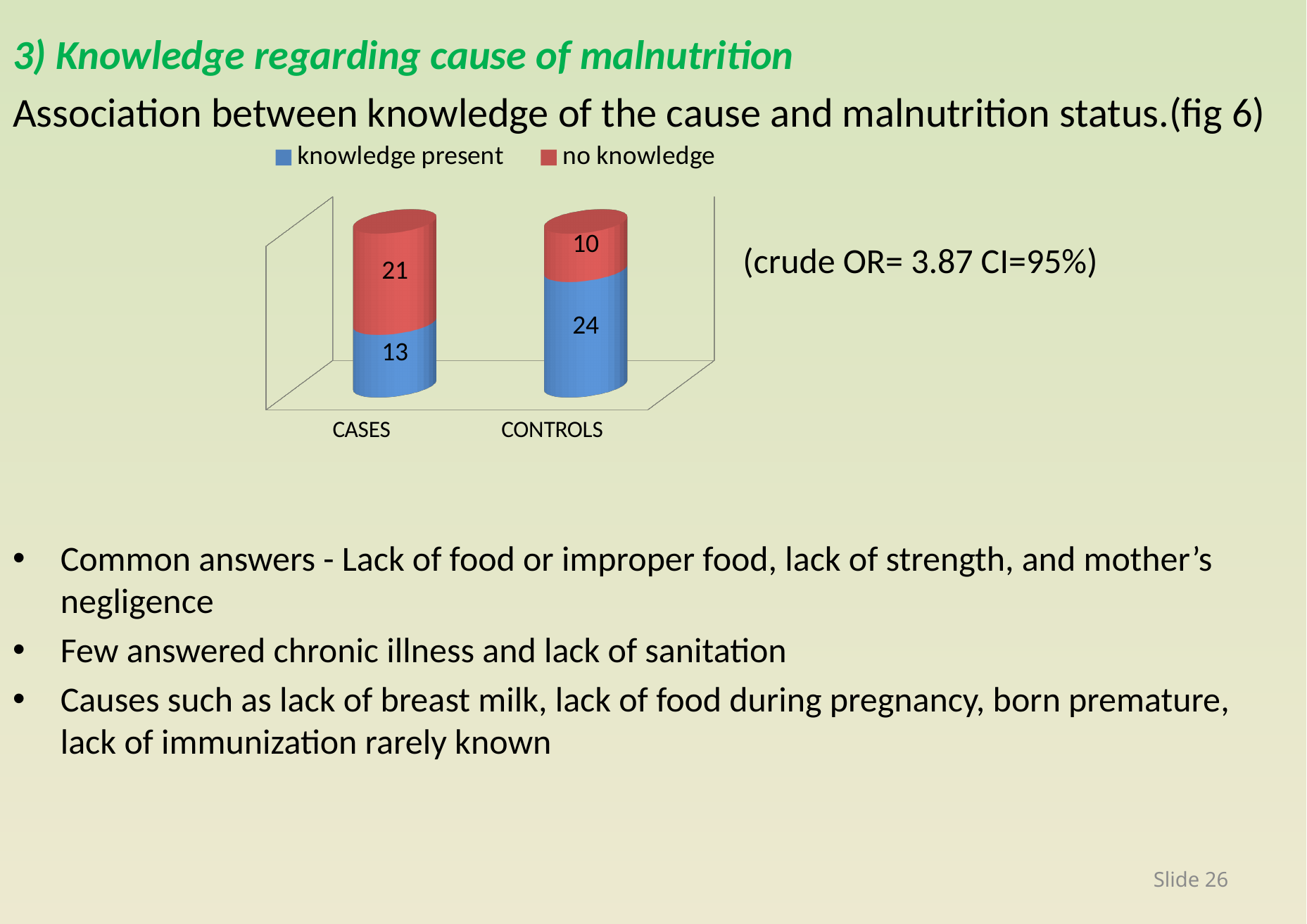
What kind of chart is shown on the slide? Stacked bar chart What is the total of the stacked bar for CASES? 34 What is the difference between the 'no knowledge' values for CASES and CONTROLS? 11 What is the total of the stacked bar for CONTROLS? 34 What is the value for 'knowledge present' in the CONTROLS category? 24 What is the value for 'no knowledge' in the CONTROLS category? 10 Which category has the lowest 'no knowledge' value? CONTROLS Which category has the higher 'knowledge present' value, CASES or CONTROLS? CONTROLS How many series does the chart legend list? 2 How many categories are shown on the x axis of the chart? 2 What is the value for 'no knowledge' in the CASES category? 21 What is the value for 'knowledge present' in the CASES category? 13